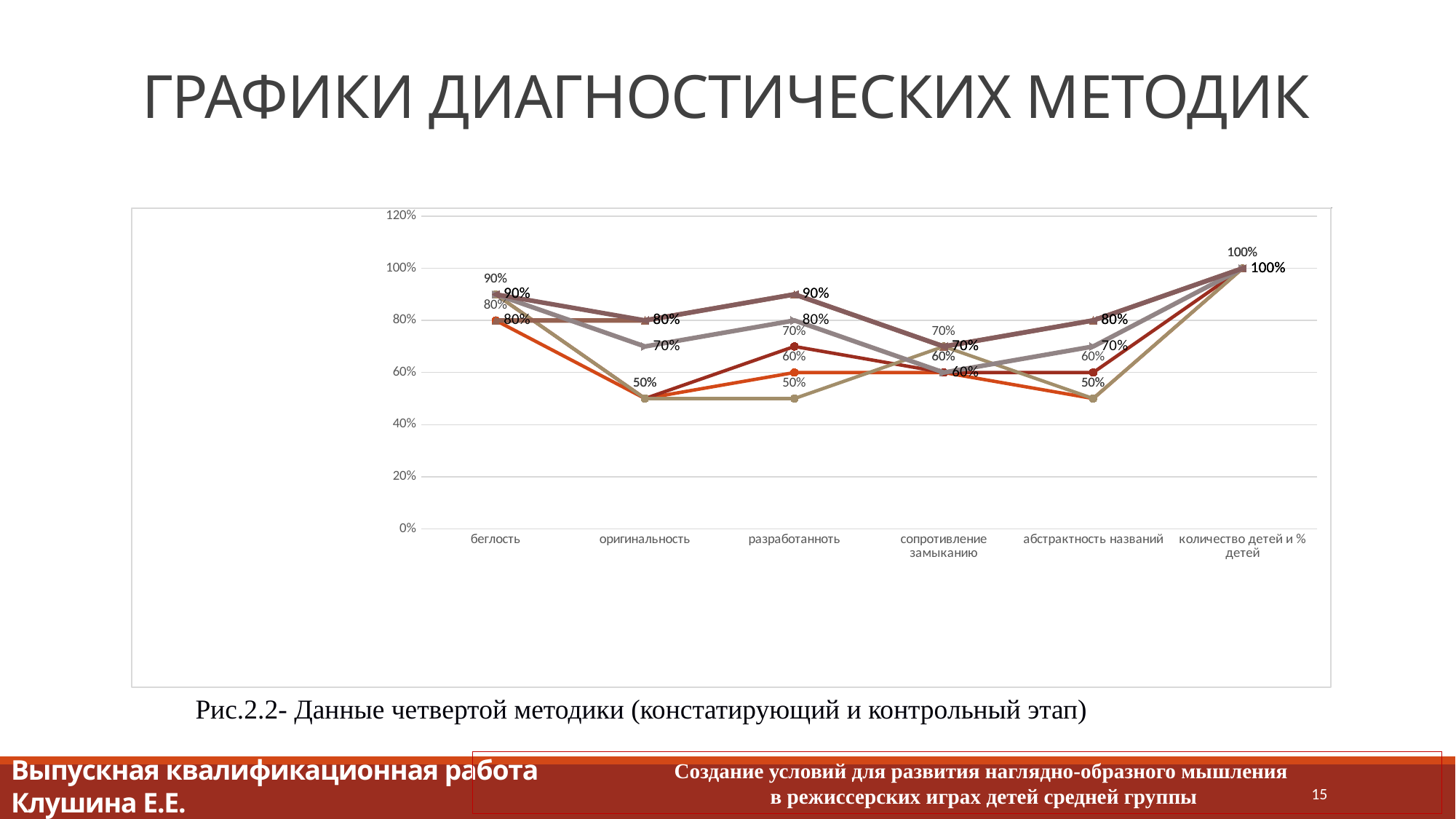
What is the lowest value plotted for the category 'абстрактность названий'? 50% What is the lowest value plotted for the category 'разработанность'? 50% What is the highest value plotted for the category 'разработанность'? 90% What is the highest tick shown on the vertical axis of the chart? 120% What value do all the lines reach at the category 'количество детей и % детей'? 100% What is the difference between the highest and lowest values plotted at 'разработанность'? 40 percentage points What is the highest value plotted for the category 'сопротивление замыканию'? 70% What kind of chart is shown on the slide? line chart What is the highest value plotted for the category 'беглость'? 90% Are the values at 'количество детей и % детей' greater or less than 80%? greater What is the lowest value plotted for the category 'оригинальность'? 50% How many categories are shown on the x axis of the chart? 6